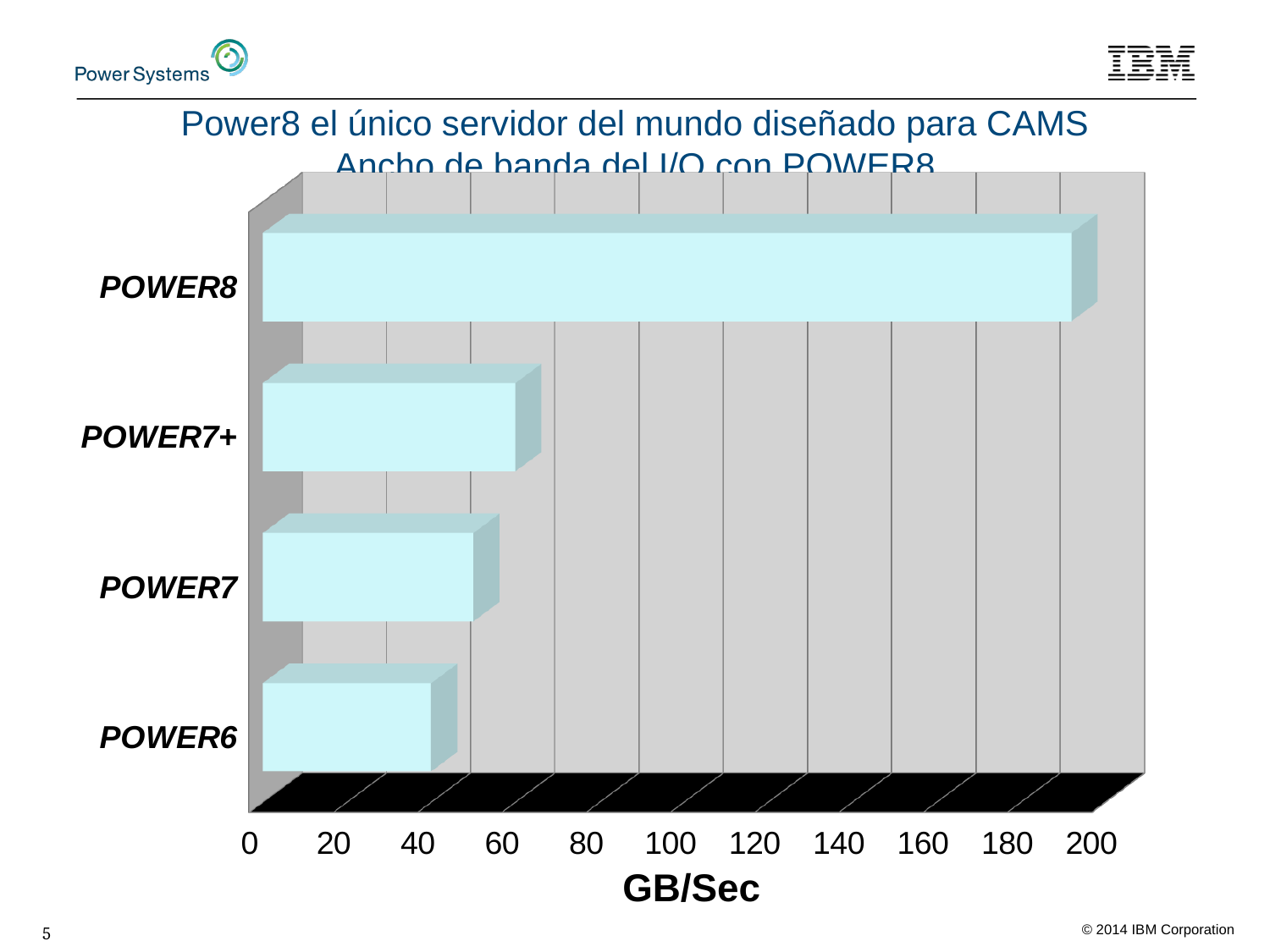
Which processor has the highest I/O bandwidth in the chart? POWER8 Is the value for POWER8 greater or less than 180? greater Which has the larger value, POWER8 or POWER7+? POWER8 What kind of chart is shown on the slide? bar chart Is the value for POWER7+ greater or less than 80? less What unit is shown on the horizontal axis of the chart? GB/Sec Is the value for POWER7 greater or less than 60? less How many categories (processor generations) are plotted in the chart? 4 Which has the larger value, POWER7+ or POWER7? POWER7+ Which processor has the lowest I/O bandwidth in the chart? POWER6 What is the maximum value shown on the horizontal axis of the chart? 200